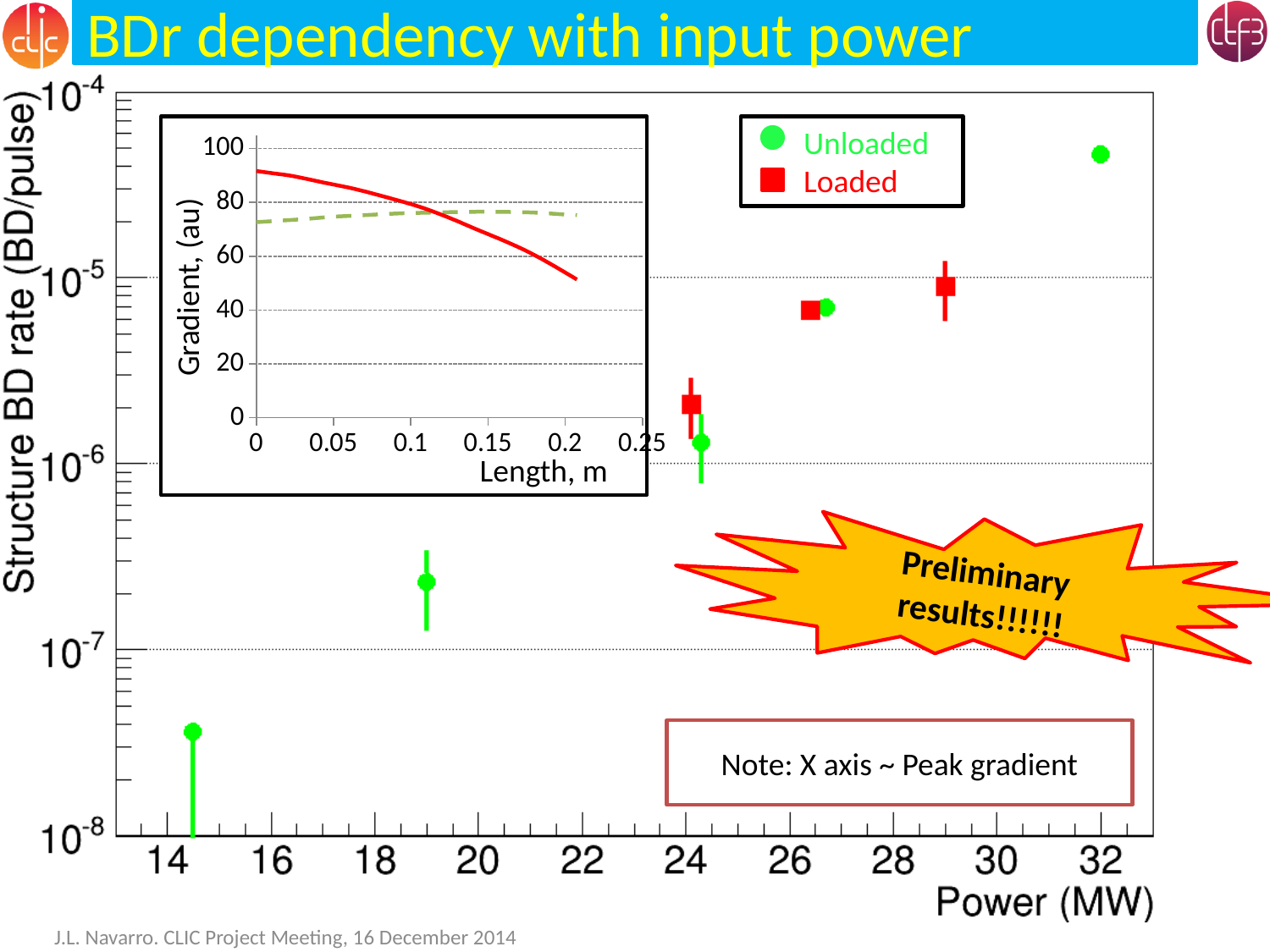
On the main chart, how many series does the legend list? 2 On the main chart, is the Loaded BD rate at about 26.4 MW greater or less than 10^-5? less What is the x-axis label of the main chart? Power (MW) On the main chart, what are the two series named in the legend? Unloaded and Loaded On the main chart, does the structure BD rate generally rise or fall as power increases? rise On the main chart, is the Unloaded BD rate at 32 MW greater or less than 10^-5? greater On the main chart, is the Unloaded BD rate at about 19 MW greater or less than 10^-6? less On the main chart, how many Loaded (red) data points are plotted? 3 On the main chart, how many Unloaded (green) data points are plotted? 5 In the inset chart, does the solid red gradient line rise or fall as length increases? fall